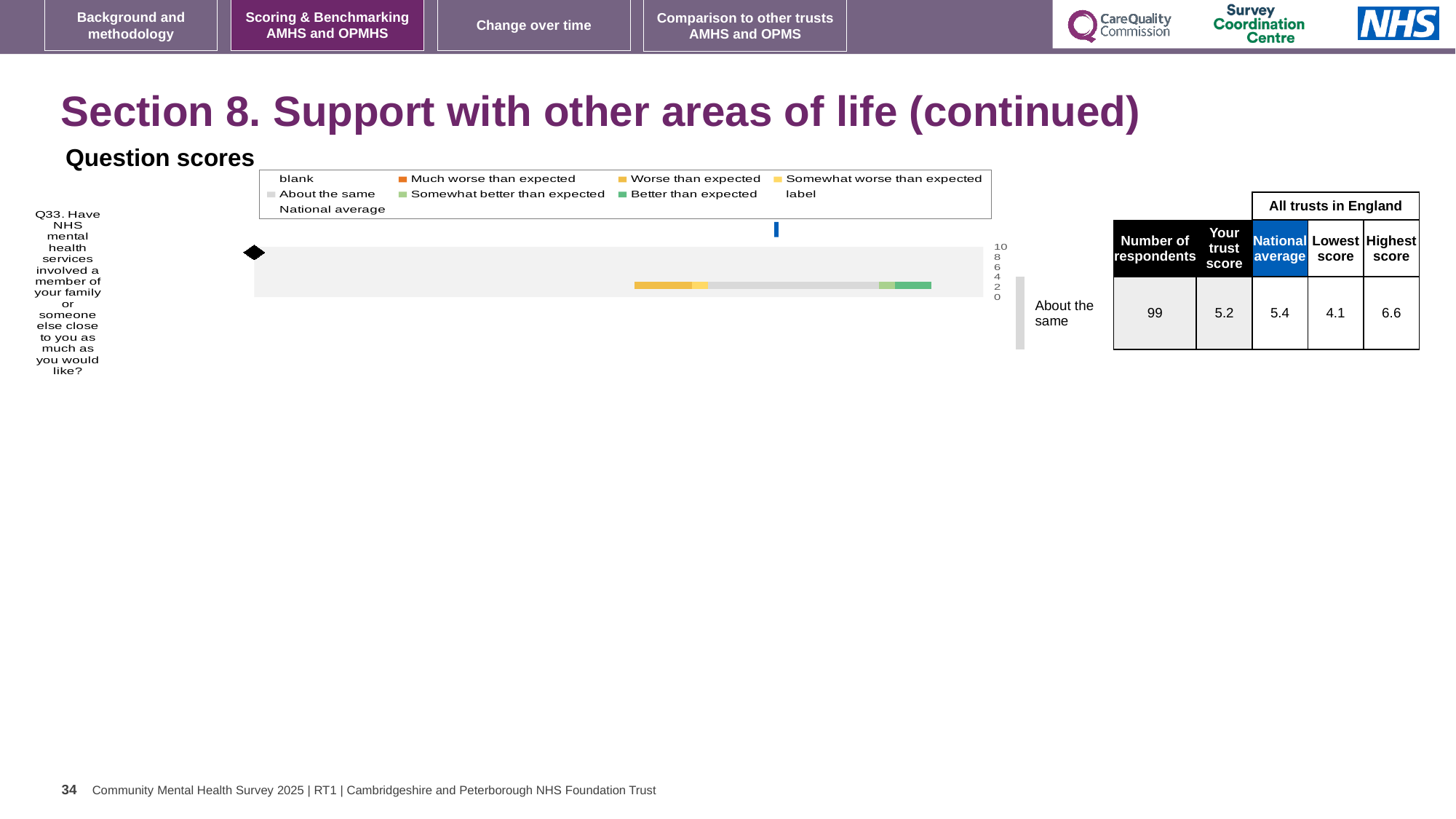
Which benchmark category is the trust's Q33 score placed in? About the same How many entries does the legend of the Question scores chart list? 9 What is the difference between the highest and lowest trust scores for Q33? 2.5 What is the trust's score for Q33 (involving a family member or someone close as much as you would like)? 5.2 What kind of chart is used to show the Q33 question score? bar chart How many respondents answered Q33? 99 What is the national average score for Q33? 5.4 How many survey questions are plotted in the Question scores chart? 1 Which is larger for Q33: the trust's score or the national average? National average By how much does the national average exceed the trust's score for Q33? 0.2 What is the lowest score among all trusts in England for Q33? 4.1 What is the highest score among all trusts in England for Q33? 6.6